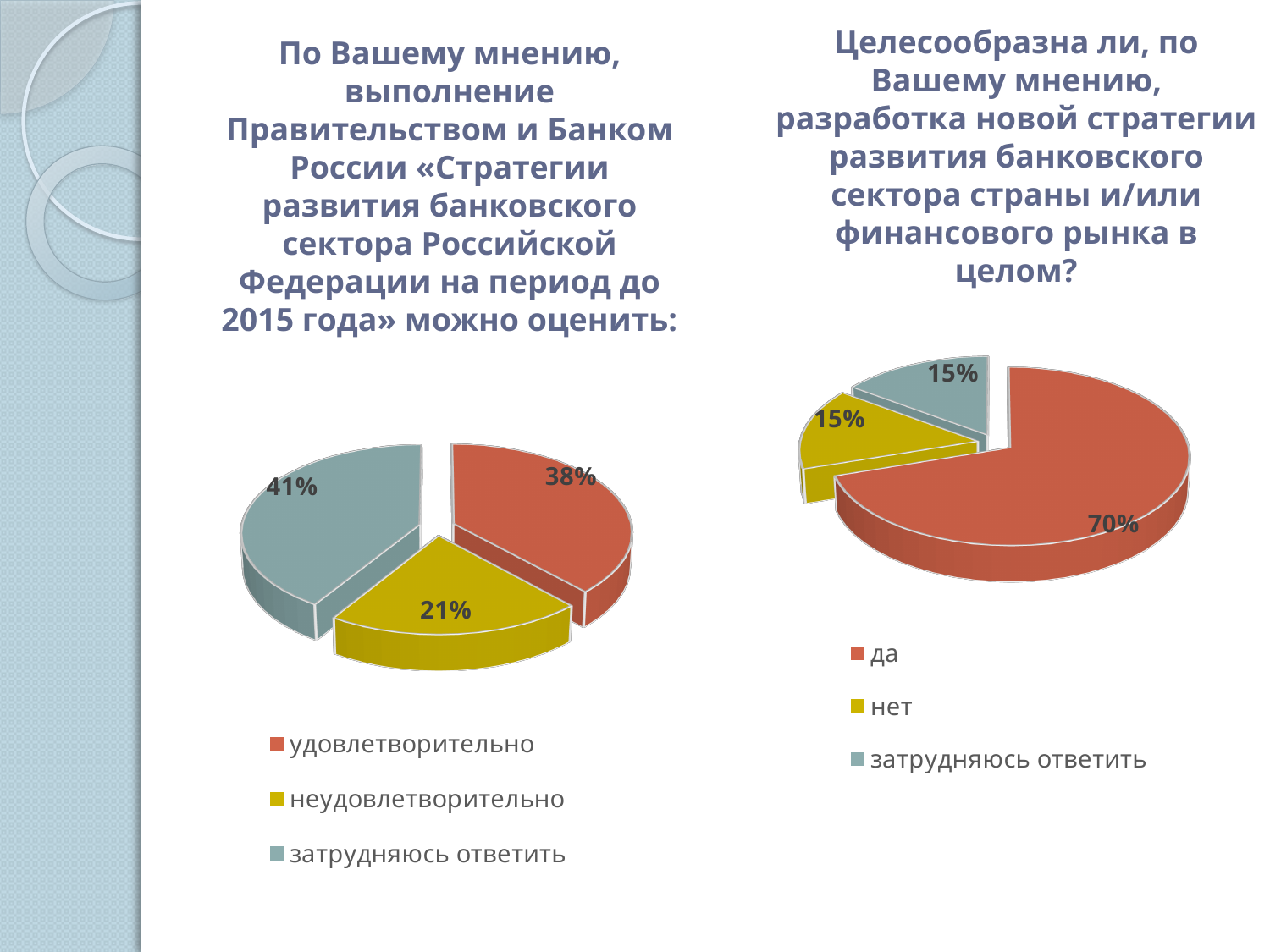
In the right pie chart, what share of respondents answered «да»? 70% What type of chart is shown on the right side of the slide? pie chart In the right pie chart, what is the difference between the shares for «да» and «нет»? 55% In the left pie chart, how many slices does the pie have? 3 In the left pie chart, which answer has the largest share? затрудняюсь ответить In the right pie chart, which answer has the largest share? да In the right pie chart, how many entries does the legend list? 3 In the left pie chart, what is the difference between the shares for «затрудняюсь ответить» and «удовлетворительно»? 3% In the right pie chart, what share of respondents answered «нет»? 15% In the left pie chart, what share of respondents answered «неудовлетворительно»? 21% In the left pie chart, what share of respondents answered «удовлетворительно»? 38% In the left pie chart, which answer has the smallest share? неудовлетворительно